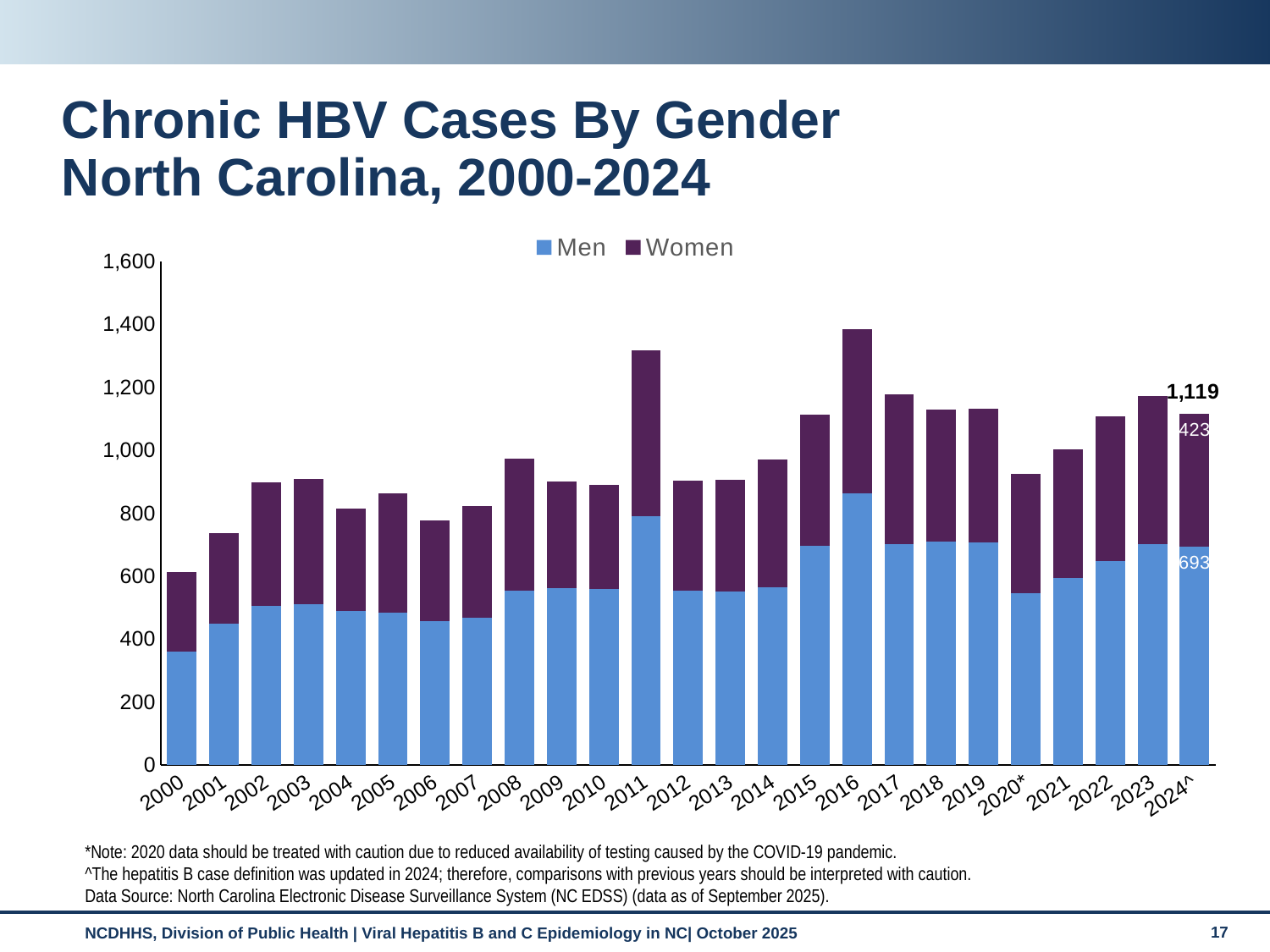
Which year has the highest total number of chronic HBV cases? 2016 Which year has the lowest total number of chronic HBV cases? 2000 What total number of cases is labelled above the 2024 bar? 1,119 Which colour represents women in the chart? Purple What kind of chart is shown on the slide? Stacked bar chart How many series does the legend list? 2 Is the total number of cases in 2016 greater or less than 1,200? greater What is the number of chronic HBV cases among men in 2024? 693 Is the total number of cases in 2000 greater or less than 800? less In 2024, which group has more cases, men or women? Men What is the number of chronic HBV cases among women in 2024? 423 How many years are shown along the x axis? 25